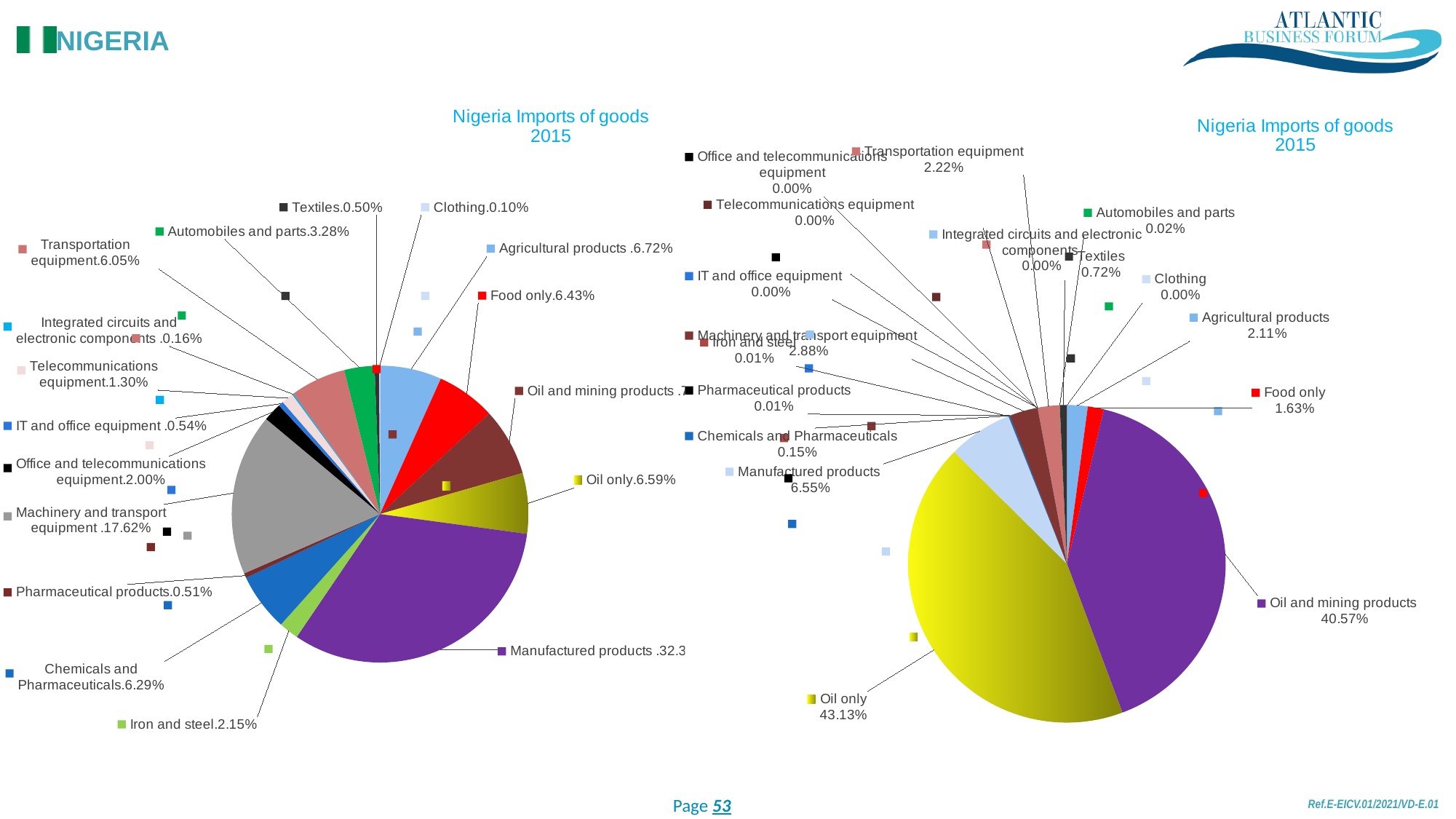
In the left pie chart, what is the share for Machinery and transport equipment? 17.62% In the right pie chart, which category has the largest share? Oil only In the right pie chart, what is the difference between the shares of Oil only and Oil and mining products? 2.56% In the left pie chart, which is larger: Food only or Transportation equipment? Food only In the right pie chart, what is the share for Manufactured products? 6.55% In the left pie chart, what is the share for Iron and steel? 2.15% What type of chart is shown on the left side of the slide? Pie chart What is the title of the left pie chart? Nigeria Imports of goods 2015 In the left pie chart, what is the share for Agricultural products? 6.72% How many categories are shown in the right pie chart? 17 In the right pie chart, what is the share for Oil and mining products? 40.57% In the right pie chart, which is larger: Machinery and transport equipment or Agricultural products? Machinery and transport equipment